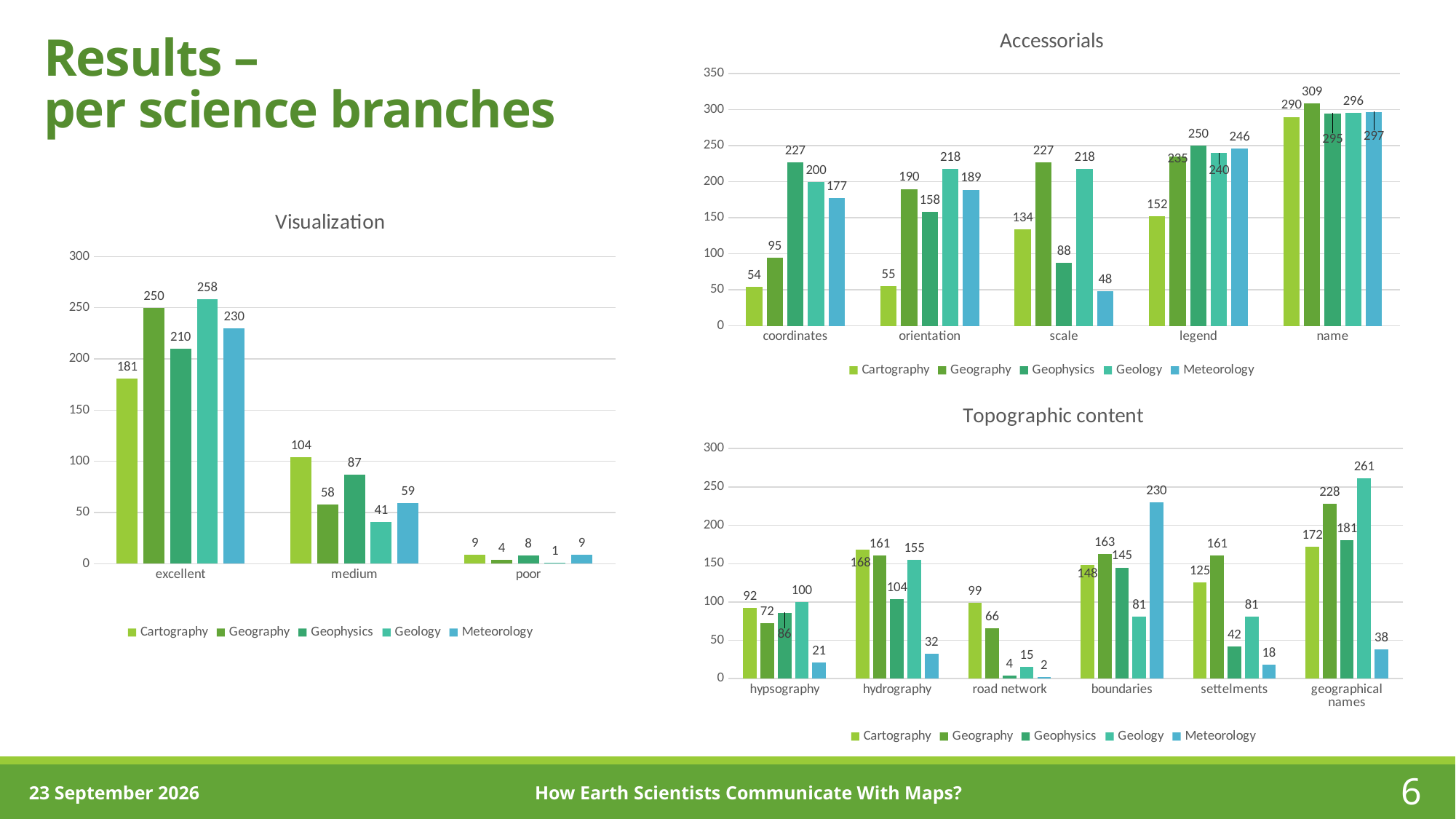
In the Accessorials chart, which series has the highest value in the name category? Geography In the Visualization chart, what is the value for Geology in the excellent category? 258 In the Visualization chart, which series has the lowest value in the poor category? Geology In the Visualization chart, what is the difference between Cartography and Geophysics in the medium category? 17 In the Accessorials chart, what is the value for Meteorology in the scale category? 48 How many series does the legend of the Visualization chart list? 5 How many categories are shown on the x axis of the Accessorials chart? 5 What kind of chart is the Topographic content chart? Bar chart In the Accessorials chart, which is larger for coordinates: Geophysics or Geology? Geophysics In the Topographic content chart, what is the difference between Cartography and Geography in the settlements category? 36 In the Topographic content chart, what is the value for Meteorology in the boundaries category? 230 In the Topographic content chart, which series has the highest value in the geographical names category? Geology